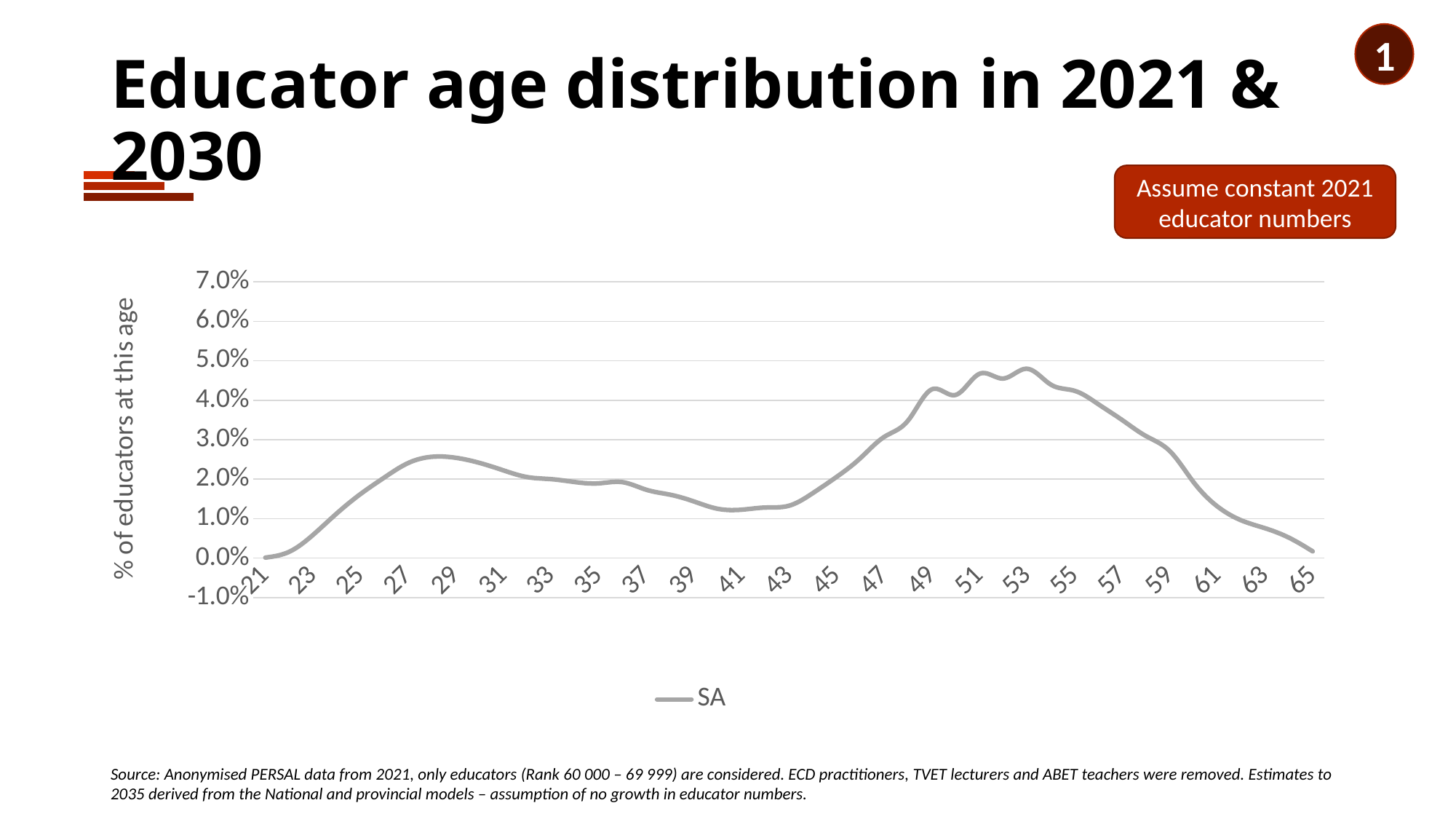
At which age does the SA line have its lowest value? 21 Is the value for age 41 greater or less than 2.0%? less Is the value for age 29 greater or less than 2.0%? greater What is the title of the vertical axis of the chart? % of educators at this age Does the SA line rise or fall between age 53 and age 65? fall Which age has the larger value, 29 or 53? 53 What kind of chart is shown on the slide? line chart Is the value for age 65 greater or less than 1.0%? less What is the name of the series shown in the chart legend? SA How many series does the chart legend list? 1 At which age does the SA line reach its highest value? 53